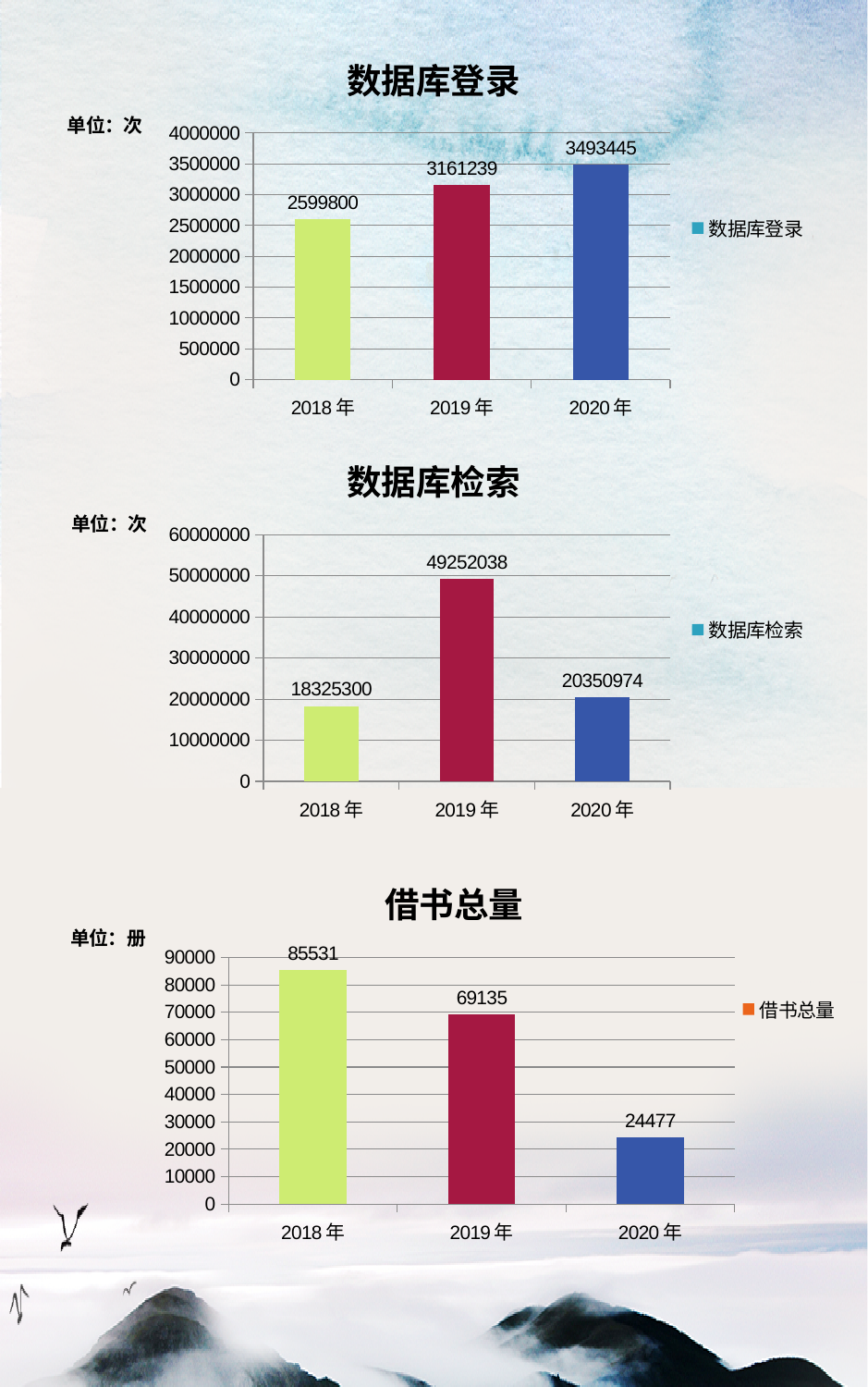
In the 数据库登录 chart, which year has the highest value? 2020年 In the 数据库登录 chart, do the values rise or fall from 2018年 to 2020年? rise In the 借书总量 chart, what is the difference between the 2018年 and 2020年 values? 61054 In the 借书总量 chart, what is the value for 2020年? 24477 How many categories does the 借书总量 chart show? 3 In the 数据库检索 chart, which year has the lowest value? 2018年 In the 数据库检索 chart, what is the difference between the 2019年 and 2018年 values? 30926738 In the 数据库登录 chart, what is the difference between the 2020年 and 2018年 values? 893645 In the 数据库登录 chart, what is the value for 2019年? 3161239 In the 数据库检索 chart, what is the value for 2019年? 49252038 What kind of chart is the 数据库检索 chart? bar chart In the 借书总量 chart, which is larger, the value for 2018年 or 2019年? 2018年